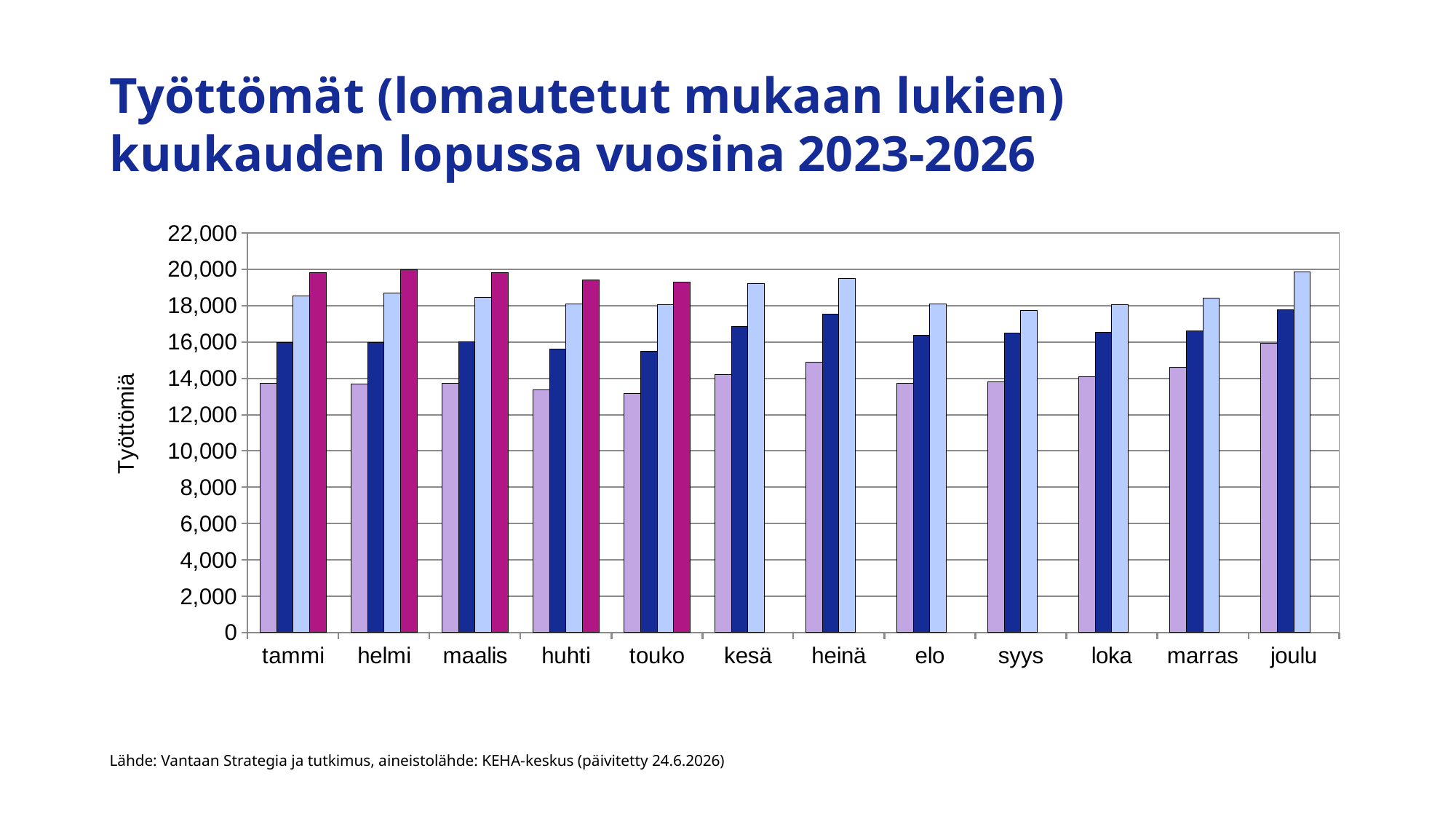
Is the value of the light blue bar for joulu greater or less than 18,000? greater Do the magenta bars rise or fall from helmi to touko? fall Is the value of the magenta bar for tammi greater or less than 18,000? greater What is the label on the vertical axis of the chart? Työttömiä Is the value of the dark blue bar for heinä greater or less than 16,000? greater In how many months does the chart show a magenta bar? 5 How many months are shown on the x axis of the chart? 12 For joulu, which bar is taller: the light blue bar or the light purple bar? the light blue bar For tammi, which bar is taller: the magenta bar or the dark blue bar? the magenta bar What kind of chart is shown on the slide? bar chart